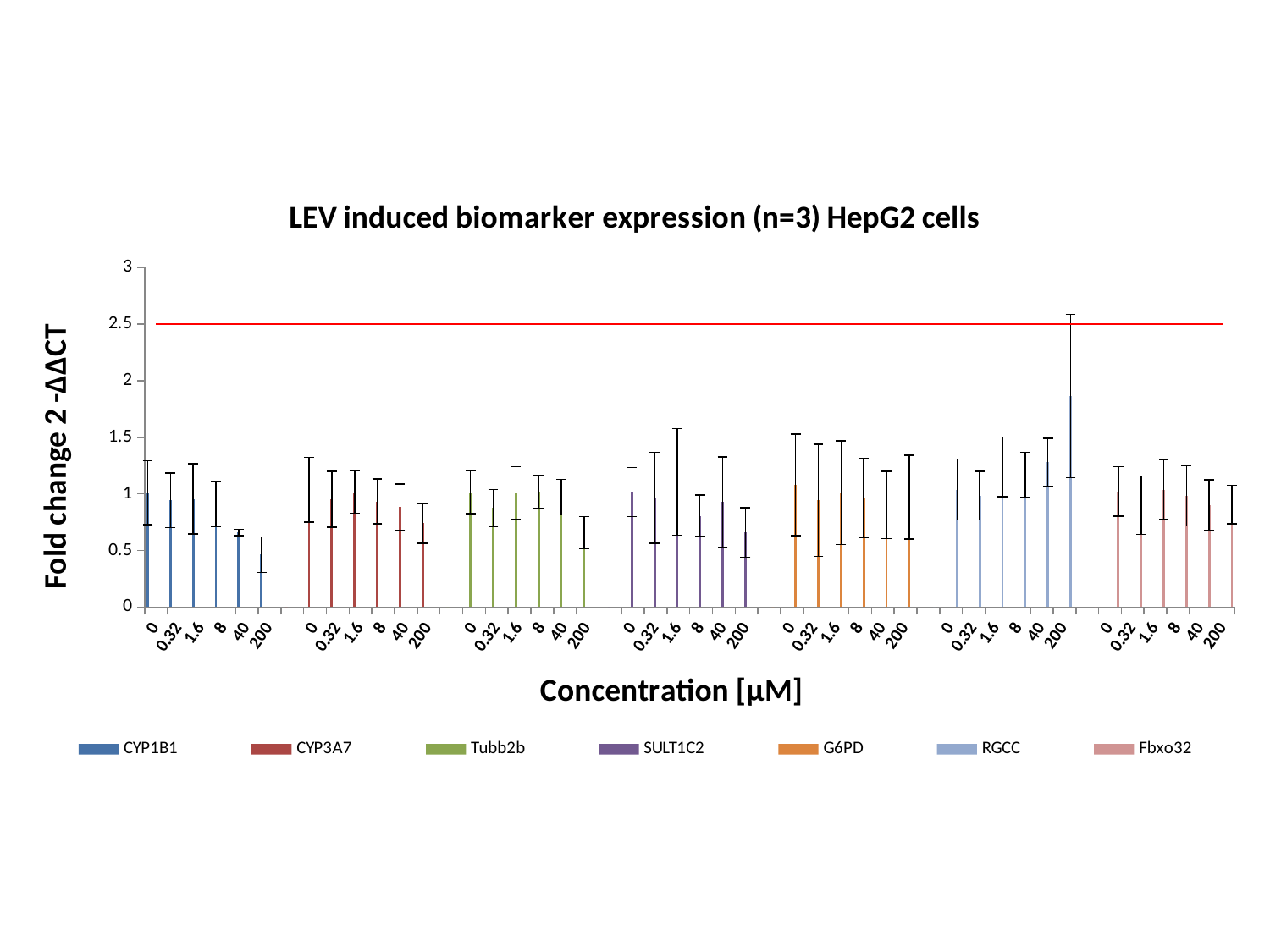
Is the value for G6PD at 0 µM greater or less than 1? greater What is the title of the chart? LEV induced biomarker expression (n=3) HepG2 cells What kind of chart is shown on the slide? Bar chart How many concentration levels are plotted for each biomarker? 6 How many series does the legend list? 7 Do the CYP1B1 values rise or fall as concentration increases from 0 to 200 µM? fall Is the value for CYP1B1 at 40 µM greater or less than 1? less What is the label of the y axis? Fold change 2 -ΔΔCT Is the value for RGCC at 200 µM greater or less than 1.5? greater Which series contains the tallest bar on the chart? RGCC At what fold change value is the horizontal red line drawn? 2.5 Which is larger, the value for RGCC at 200 µM or the value for CYP1B1 at 200 µM? RGCC at 200 µM